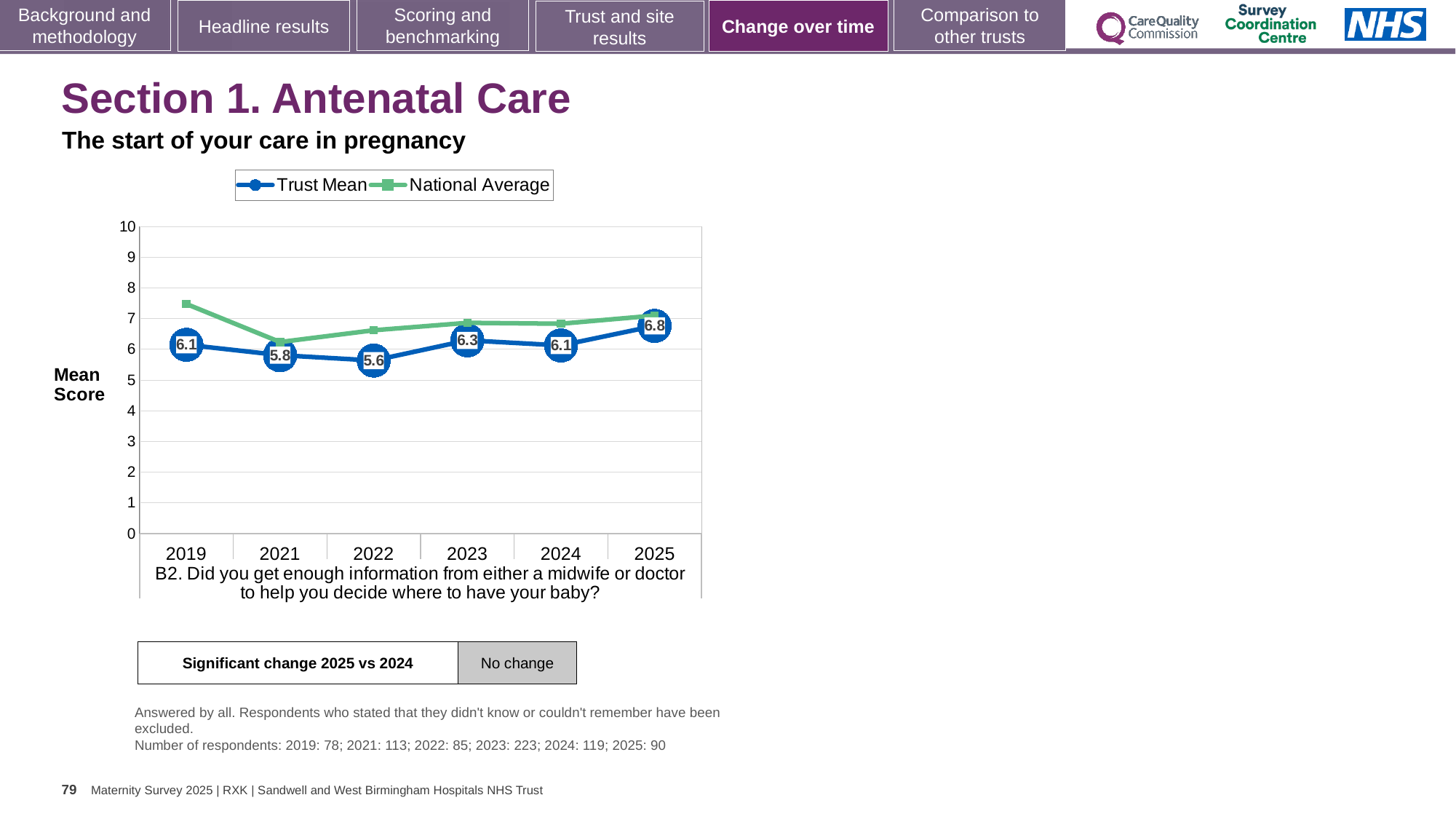
What is the Trust Mean score for 2019? 6.1 In which year is the Trust Mean lowest? 2022 Is the National Average value for 2019 greater or less than 7? greater What kind of chart is shown? Line chart What is the difference between the Trust Mean in 2025 and in 2024? 0.7 What is the Trust Mean score for 2025? 6.8 Which is larger, the Trust Mean in 2023 or in 2021? 2023 In which year is the Trust Mean highest? 2025 How many series does the legend list? 2 What is the Trust Mean score for 2022? 5.6 How many years are plotted on the x axis? 6 Does the Trust Mean rise or fall from 2022 to 2025? Rise